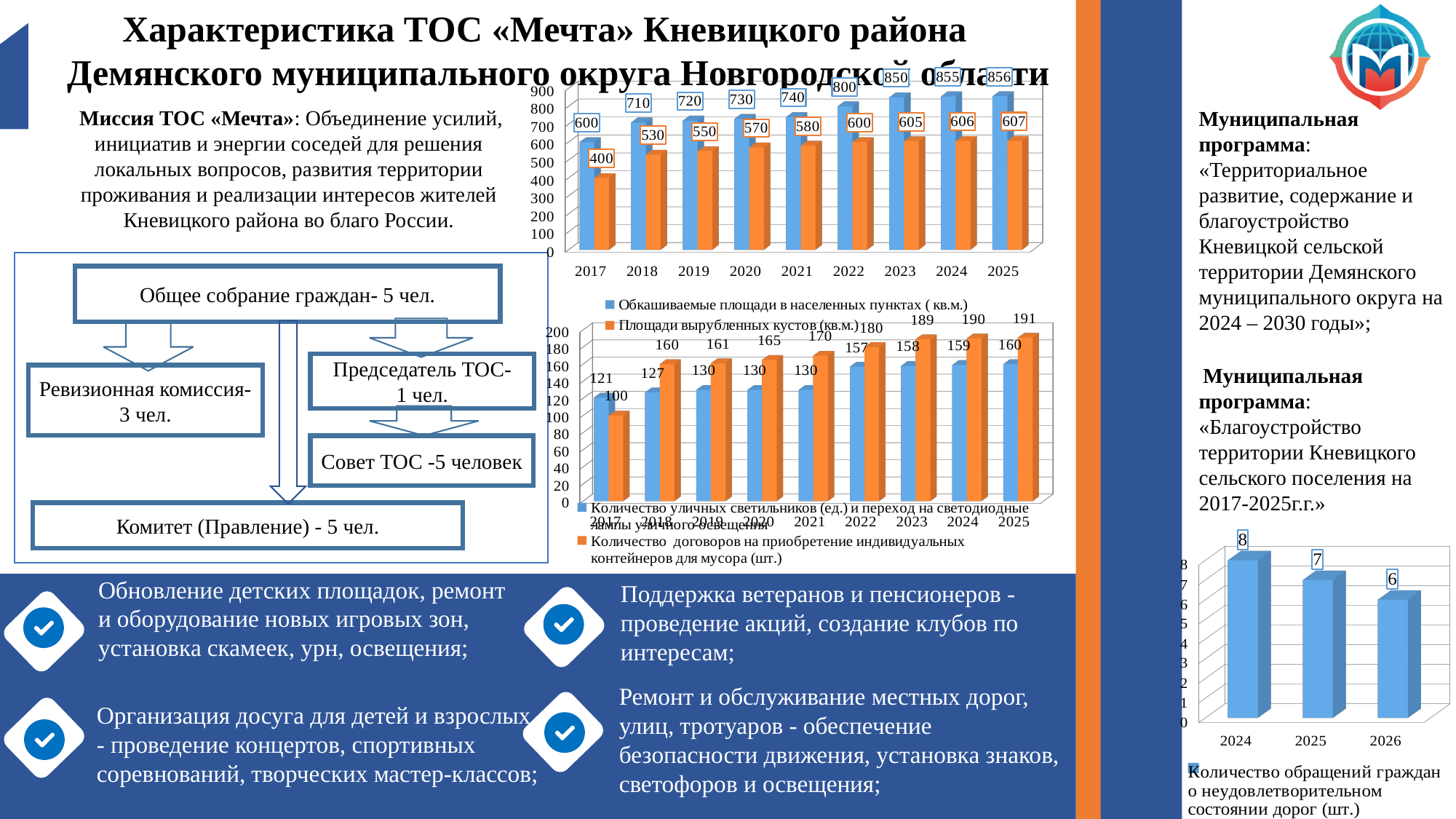
In the top chart in the middle of the slide, what is the value of the blue series (Обкашиваемые площади в населенных пунктах) for 2017? 600 What kind of chart is the bottom-right chart (Количество обращений граждан о неудовлетворительном состоянии дорог)? bar chart In the middle chart (street lights and waste container contracts), which year has the lowest value for the orange series (Количество договоров на приобретение индивидуальных контейнеров)? 2017 In the top chart in the middle of the slide, how many series does the legend list? 2 In the top chart in the middle of the slide, does the orange series (Площади вырубленных кустов) rise or fall from 2017 to 2025? rise In the middle chart (street lights and waste container contracts), which is larger in 2017: the blue series or the orange series? the blue series In the top chart in the middle of the slide, what is the difference between the blue and orange values for 2017? 200 In the top chart in the middle of the slide, what is the value of the orange series (Площади вырубленных кустов) for 2025? 607 In the middle chart (street lights and waste container contracts), what is the value of the orange series for 2021? 170 In the middle chart (street lights and waste container contracts), how many years are shown on the x axis? 9 In the top chart in the middle of the slide, which year has the highest value for the blue series (Обкашиваемые площади)? 2025 In the bottom-right chart (Количество обращений граждан о неудовлетворительном состоянии дорог), what is the value for 2025? 7